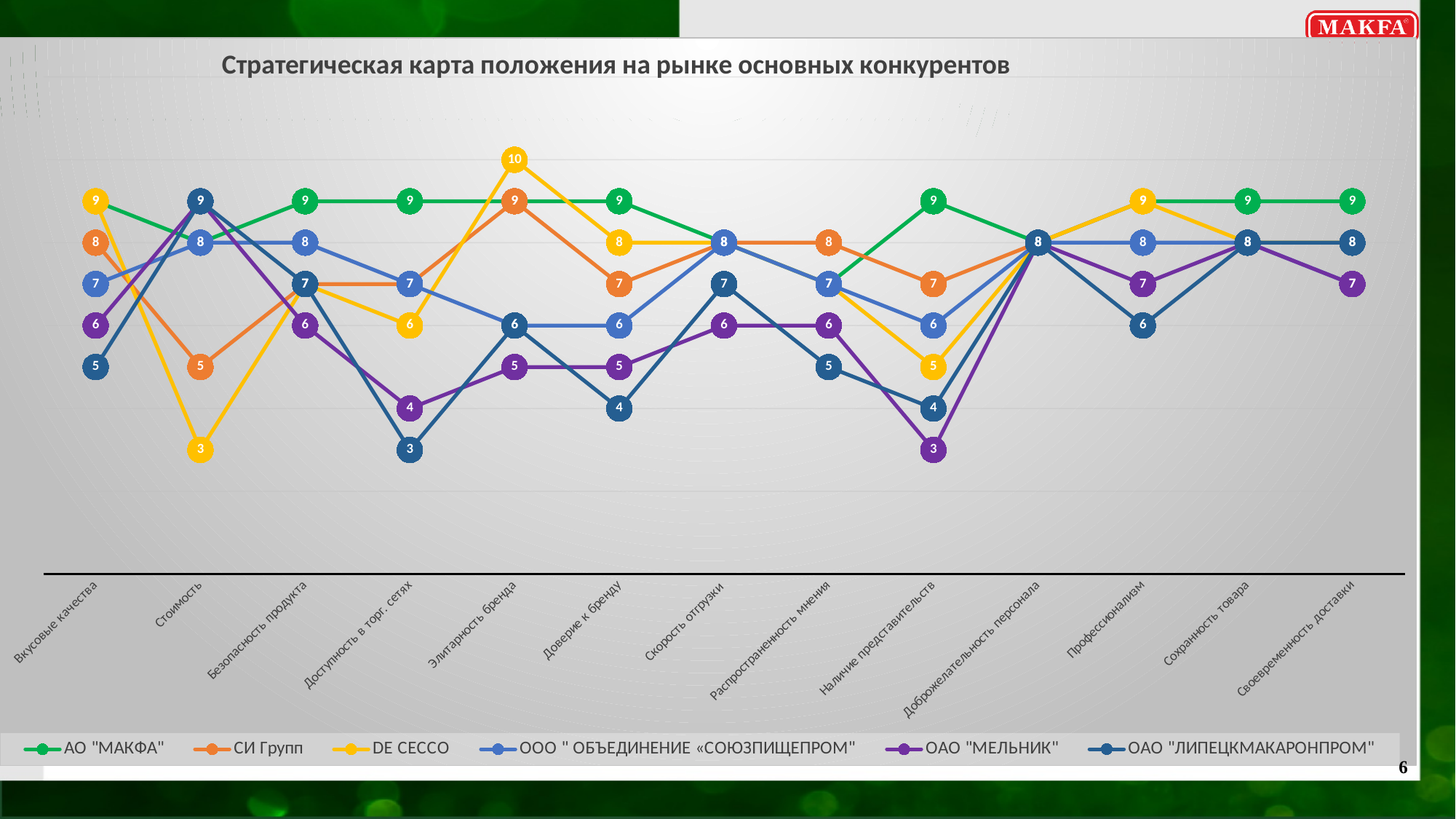
How many categories are shown along the x axis? 13 Which series has the highest value in the category Элитарность бренда? DE CECCO What is the difference between the DE CECCO values for Элитарность бренда and Стоимость? 7 What is the value for DE CECCO in the category Элитарность бренда? 10 What is the value for DE CECCO in the category Стоимость? 3 How many series does the legend list? 6 In the category Наличие представительств, which is larger: the value for АО "МАКФА" or for ОАО "МЕЛЬНИК"? АО "МАКФА" What is the value for ОАО "ЛИПЕЦКМАКАРОНПРОМ" in the category Доступность в торг. сетях? 3 What is the title of the chart? Стратегическая карта положения на рынке основных конкурентов Which series has the lowest value in the category Наличие представительств? ОАО "МЕЛЬНИК" Which series has the lowest value in the category Стоимость? DE CECCO What type of chart is shown on the slide? Line chart